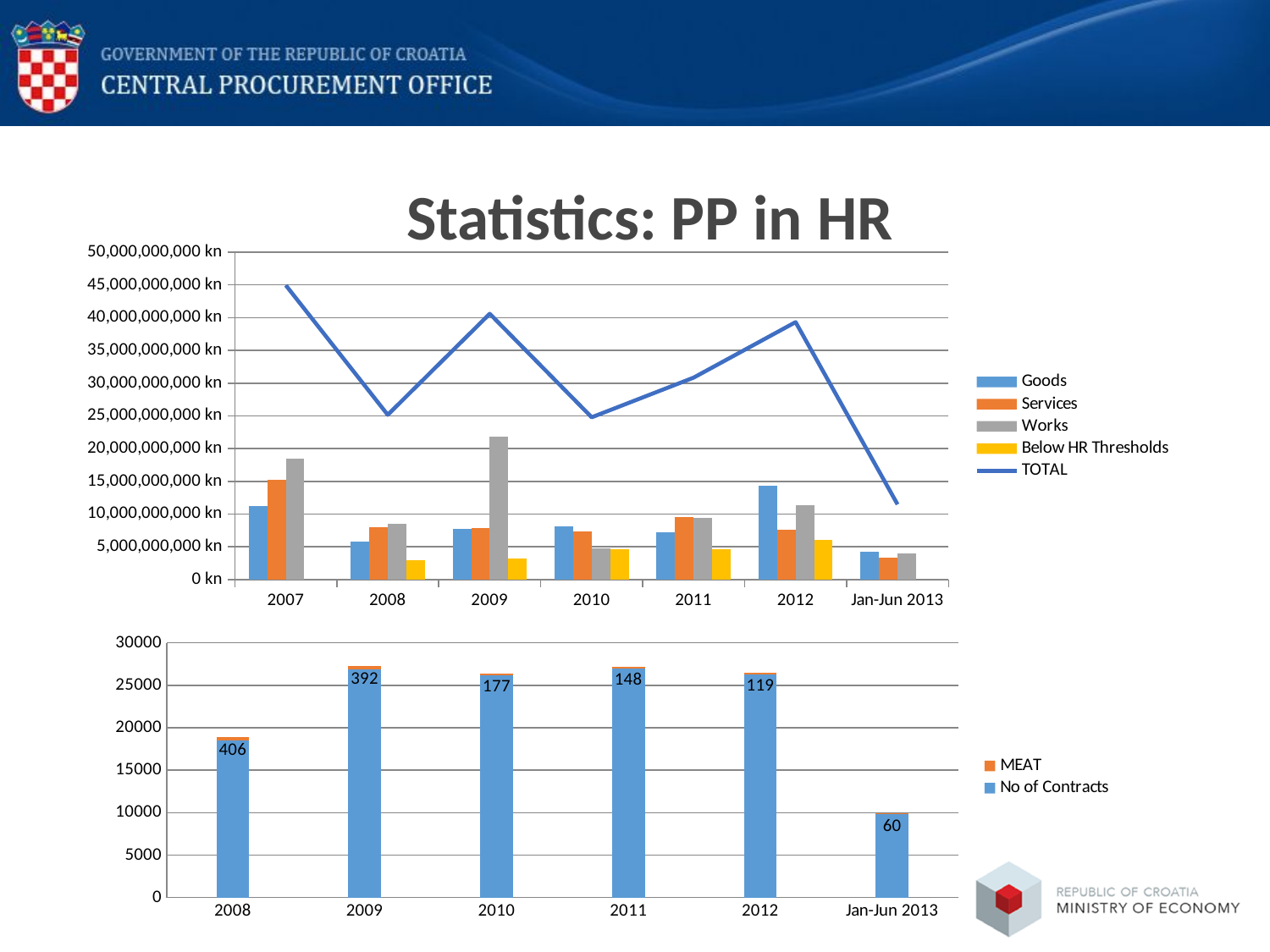
In the top chart 'Statistics: PP in HR', which is larger in 2007, Goods or Services? Services In the top chart 'Statistics: PP in HR', how many time periods are shown on the x axis? 7 In the bottom chart, what is the difference between the MEAT values for 2009 and 2010? 215 In the top chart 'Statistics: PP in HR', in which period is the TOTAL line at its lowest? Jan-Jun 2013 In the top chart 'Statistics: PP in HR', in which period is the TOTAL line at its highest? 2007 In the top chart 'Statistics: PP in HR', is the value for Goods in 2012 greater or less than 10,000,000,000 kn? greater In the bottom chart, how many series does the legend list? 2 In the top chart 'Statistics: PP in HR', how many series does the legend list? 5 In the bottom chart, what is the MEAT value labelled for 2008? 406 In the bottom chart, is the No of Contracts value for 2008 greater or less than 20000? less In the bottom chart, what is the MEAT value labelled for Jan-Jun 2013? 60 In the top chart 'Statistics: PP in HR', in which period is the Works bar the tallest? 2009